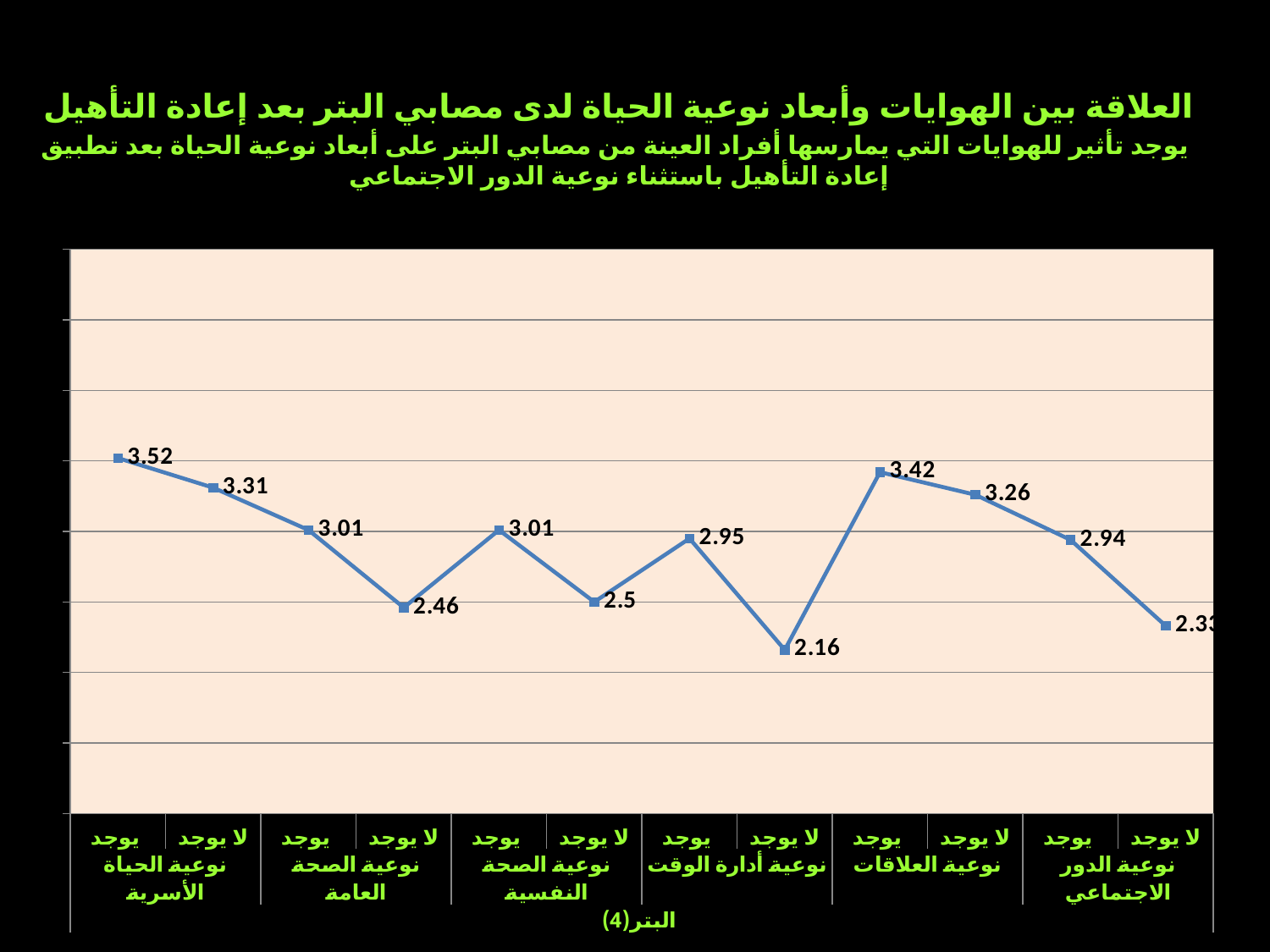
Which data point has the lowest value on the chart? لا يوجد نوعية أدارة الوقت (2.16) Which data point has the highest value on the chart? يوجد نوعية الحياة الأسرية (3.52) What is the difference between the "يوجد" and "لا يوجد" values under "نوعية أدارة الوقت"? 0.79 What is the value for "لا يوجد" under "نوعية أدارة الوقت"? 2.16 What is the value for "لا يوجد" under "نوعية الصحة العامة"? 2.46 What is the value for "يوجد" under "نوعية العلاقات"? 3.42 What is the label shown below the x axis of the chart? البتر(4) What kind of chart is shown on the slide? line chart Which is larger: the "لا يوجد" value under "نوعية الحياة الأسرية" or the "لا يوجد" value under "نوعية العلاقات"? لا يوجد نوعية الحياة الأسرية (3.31) How many data points are plotted on the line? 12 What is the difference between the "يوجد" and "لا يوجد" values under "نوعية الصحة العامة"? 0.55 What is the value for "يوجد" under "نوعية الحياة الأسرية"? 3.52